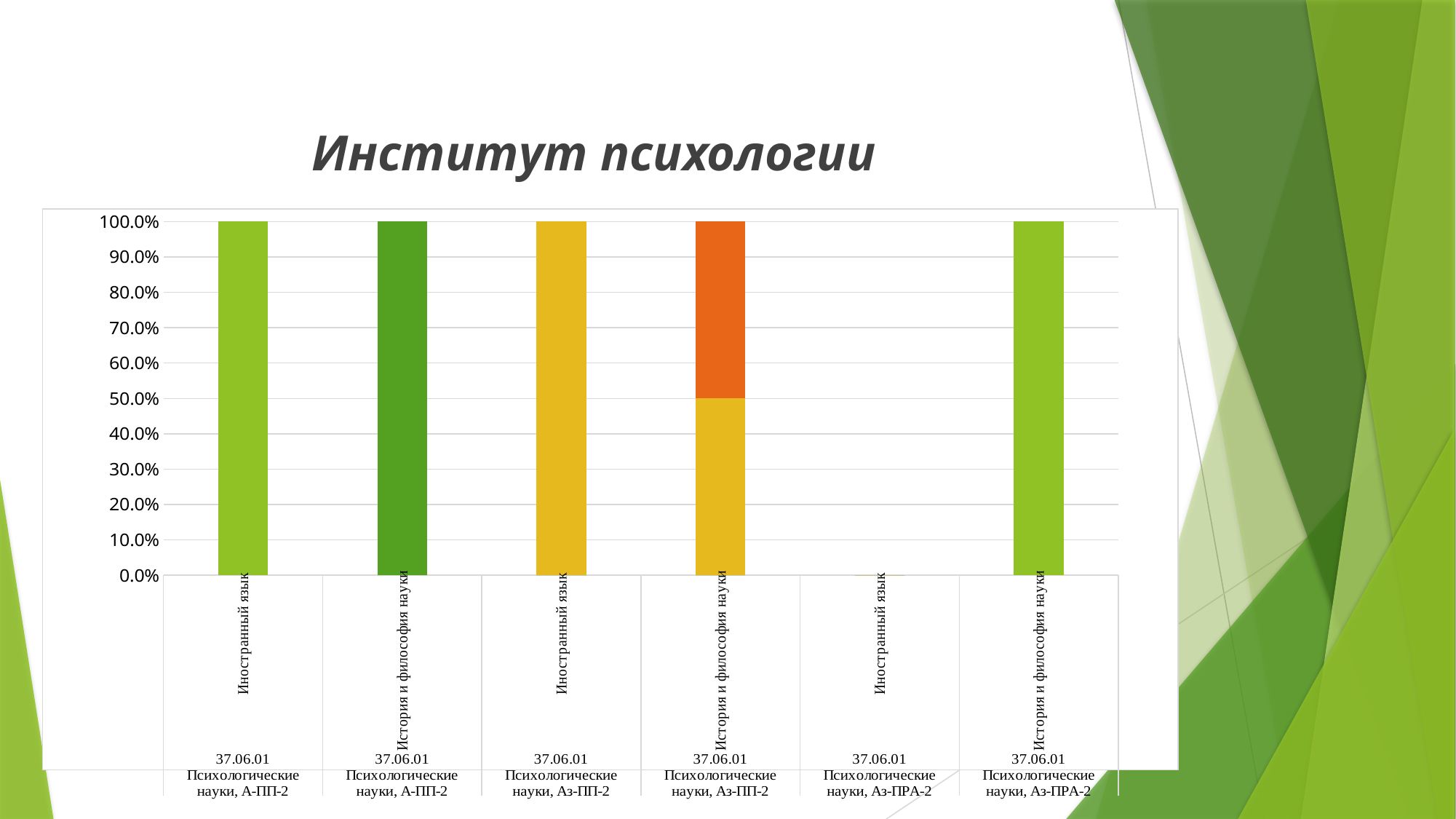
What value does the bar for Иностранный язык, 37.06.01 Психологические науки, А-ПП-2 reach? 100.0% What value does the bar for История и философия науки, 37.06.01 Психологические науки, Аз-ПРА-2 reach? 100.0% How many bars in the chart reach 100.0%? 5 At what value does the yellow segment of the bar for История и философия науки, Аз-ПП-2 end? 50.0% Is the value for Иностранный язык, Аз-ПРА-2 greater or less than 50.0%? less What is the difference between the top of the bar for История и философия науки, Аз-ПП-2 and the top of its yellow segment? 50.0% How many categories are shown along the x axis of the chart? 6 Which category has the lowest bar in the chart? Иностранный язык, 37.06.01 Психологические науки, Аз-ПРА-2 Which is larger: the bar for Иностранный язык, А-ПП-2 or the bar for Иностранный язык, Аз-ПРА-2? Иностранный язык, А-ПП-2 How many coloured segments make up the bar for История и философия науки, Аз-ПП-2? 2 What is the title of the slide above the chart? Институт психологии What kind of chart is shown on the slide? Stacked bar chart